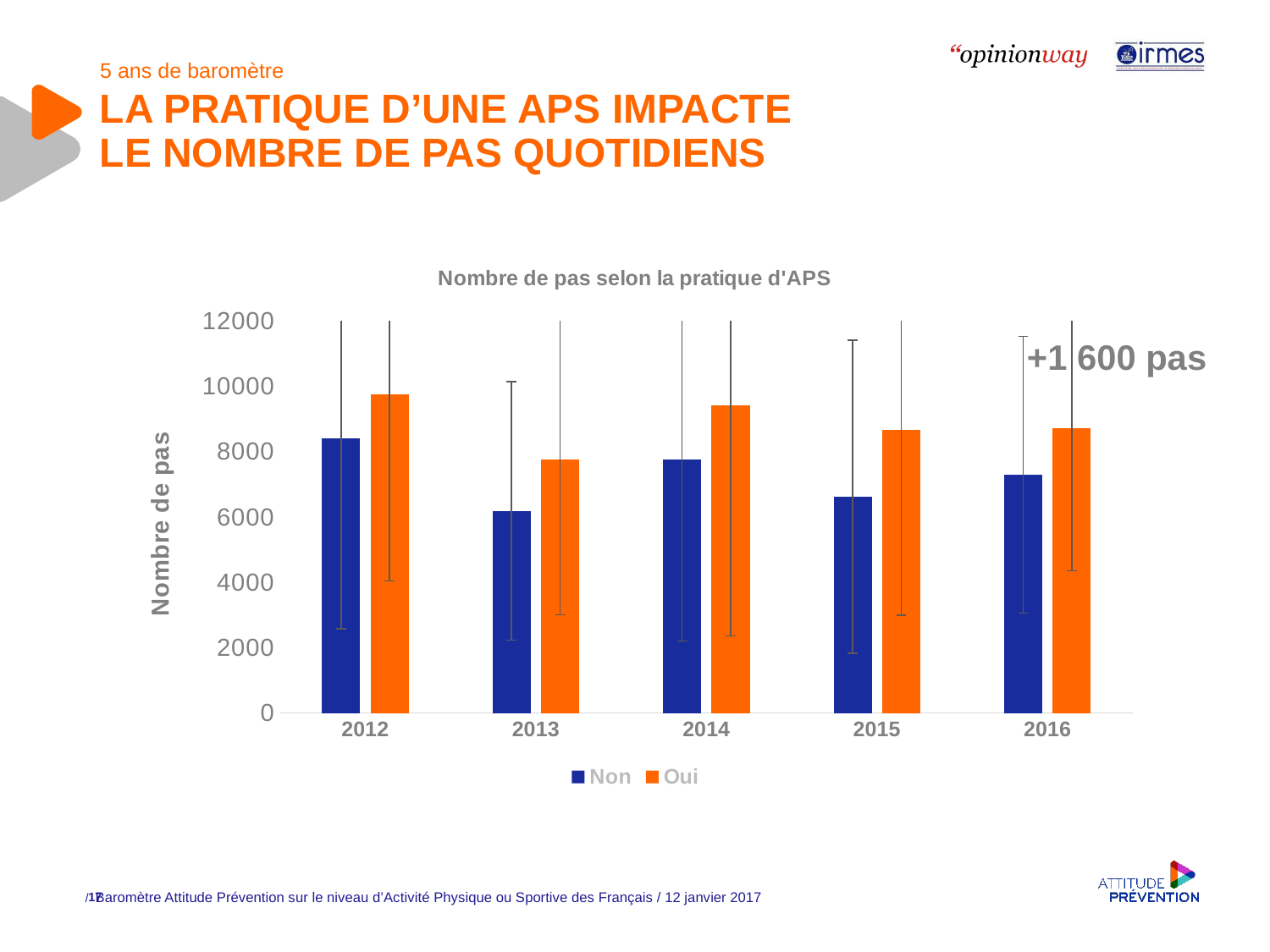
What are the two series named in the chart's legend? Non and Oui In which year is the Oui series lowest? 2013 How many series does the chart's legend list? 2 How many years are shown on the x axis of the chart? 5 In which year is the Oui series highest? 2012 Is the value for Oui in 2014 greater or less than 8000? greater In 2015, which series has the larger value, Non or Oui? Oui What is the title of the chart? Nombre de pas selon la pratique d'APS Is the value for Non in 2013 greater or less than 8000? less What kind of chart is shown on the slide? bar chart Is the value for Non in 2016 greater or less than 8000? less In which year is the Non series highest? 2012